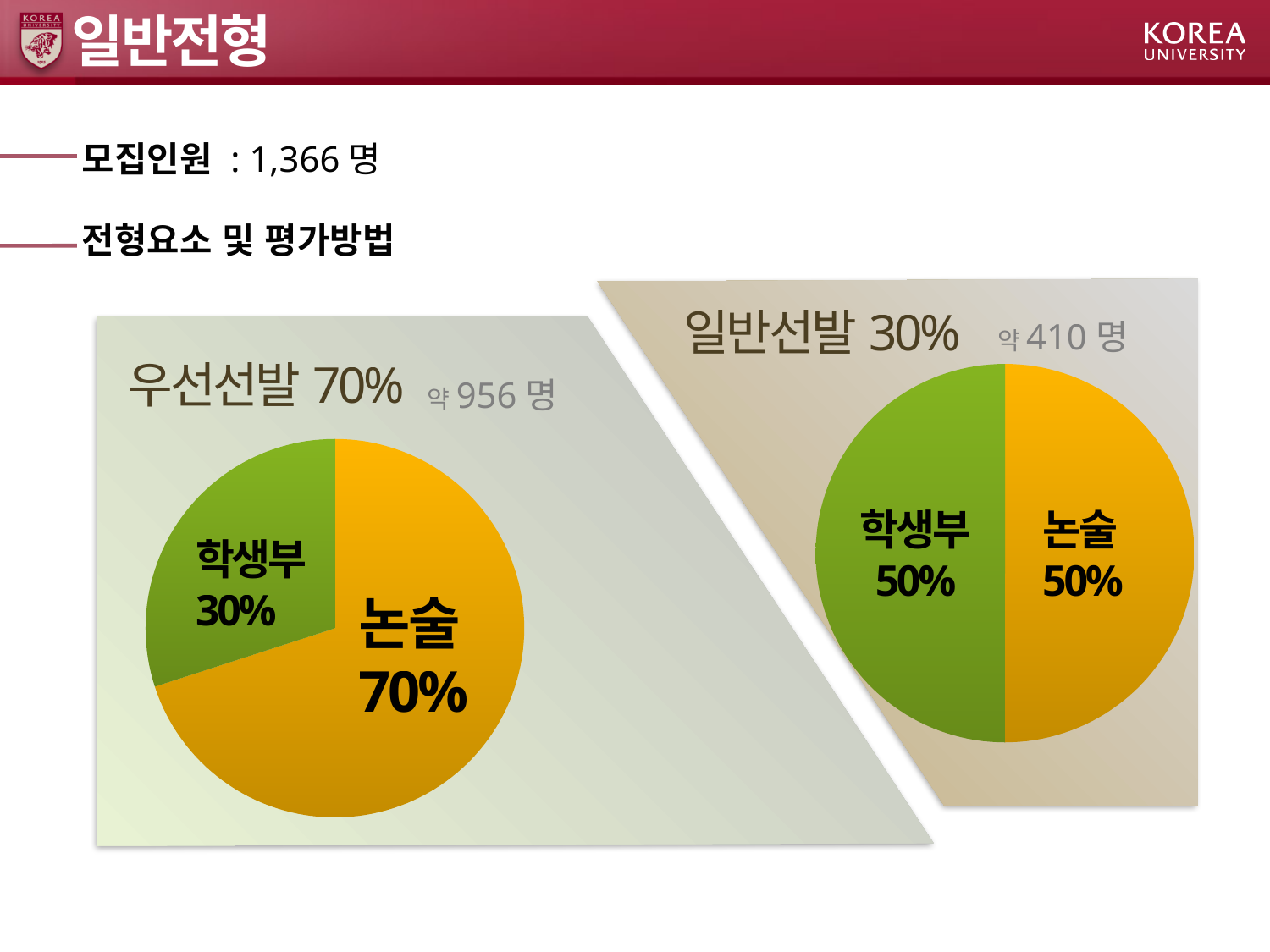
In the right pie chart (일반선발 30%), what share does 학생부 have? 50% How many pie charts are shown on the slide? 2 In the left pie chart (우선선발 70%), what share does 학생부 have? 30% In the left pie chart (우선선발 70%), what share does 논술 have? 70% In the left pie chart (우선선발 70%), which slice is the smallest? 학생부 What type of chart is used on the left side of the slide (우선선발 70%)? Pie chart In the left pie chart (우선선발 70%), which is larger, 논술 or 학생부? 논술 In the left pie chart (우선선발 70%), what is the difference between the 논술 share and the 학생부 share? 40% How many slices does the right pie chart (일반선발 30%) have? 2 In the right pie chart (일반선발 30%), what share does 논술 have? 50% In the left pie chart (우선선발 70%), which slice is the largest? 논술 What colour is the 학생부 slice in the right pie chart (일반선발 30%)? Green